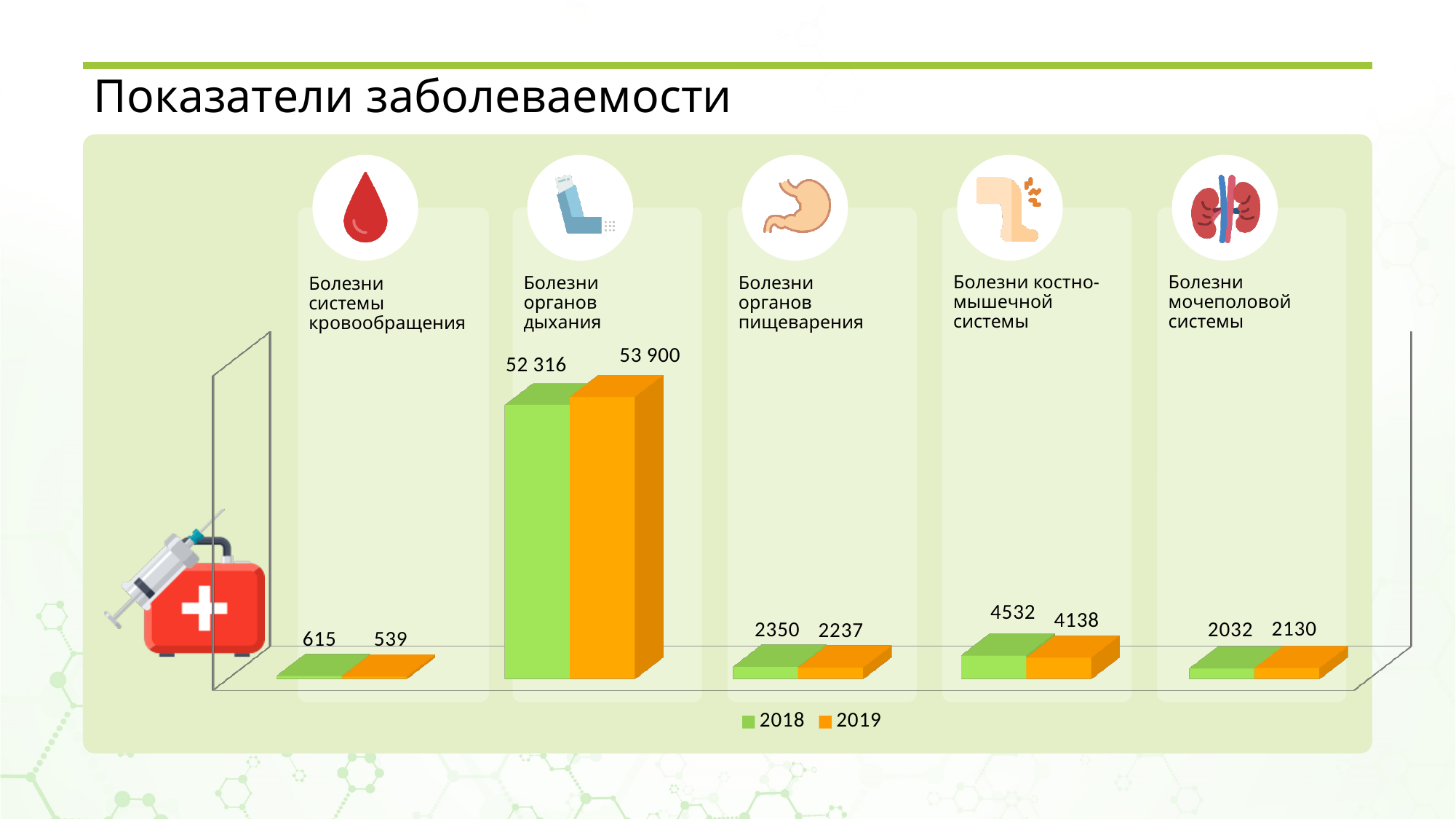
What is the 2019 value for Болезни костно-мышечной системы? 4138 What type of chart is shown on the slide? Bar chart What is the 2019 value for Болезни системы кровообращения? 539 How many disease categories are shown in the chart? 5 For Болезни мочеполовой системы, which year has the larger value, 2018 or 2019? 2019 Which category has the highest 2019 value? Болезни органов дыхания How many series does the legend list? 2 What is the difference between the 2019 and 2018 values for Болезни органов дыхания? 1 584 What is the 2018 value for Болезни органов дыхания? 52 316 What is the 2018 value for Болезни мочеполовой системы? 2032 Which category has the lowest 2018 value? Болезни системы кровообращения What is the difference between the 2018 and 2019 values for Болезни органов пищеварения? 113